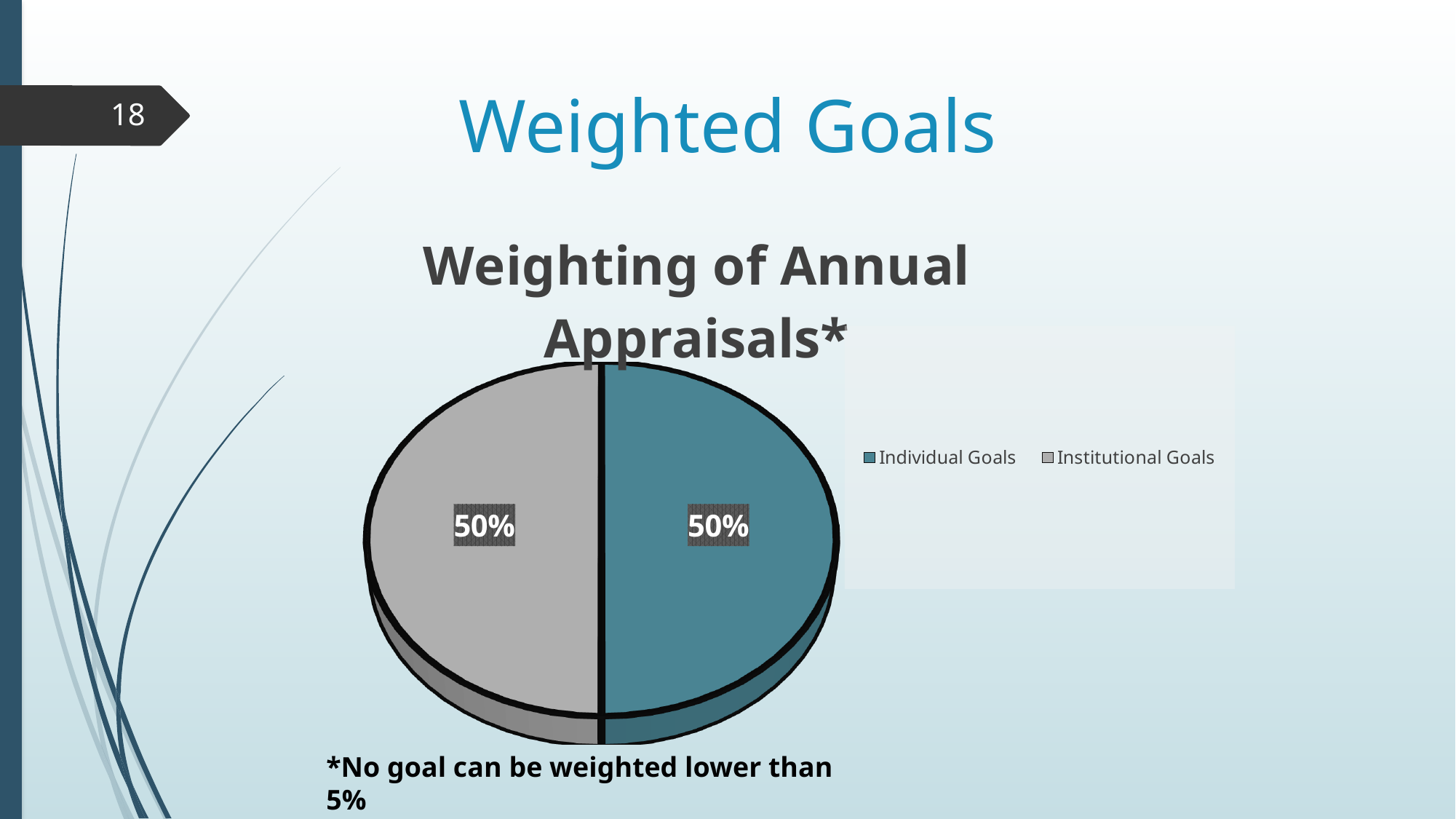
What is the total of the two slices shown? 100% What is the difference between the Individual Goals share and the Institutional Goals share? 0% What share of the pie is Individual Goals? 50% Is the value for Institutional Goals greater or less than 40%? greater What is the title of the chart? Weighting of Annual Appraisals* What kind of chart is shown on the slide? pie chart What share of the pie is Institutional Goals? 50% How many slices does the pie chart have? 2 Which legend entry is shown in teal? Individual Goals How many entries does the legend list? 2